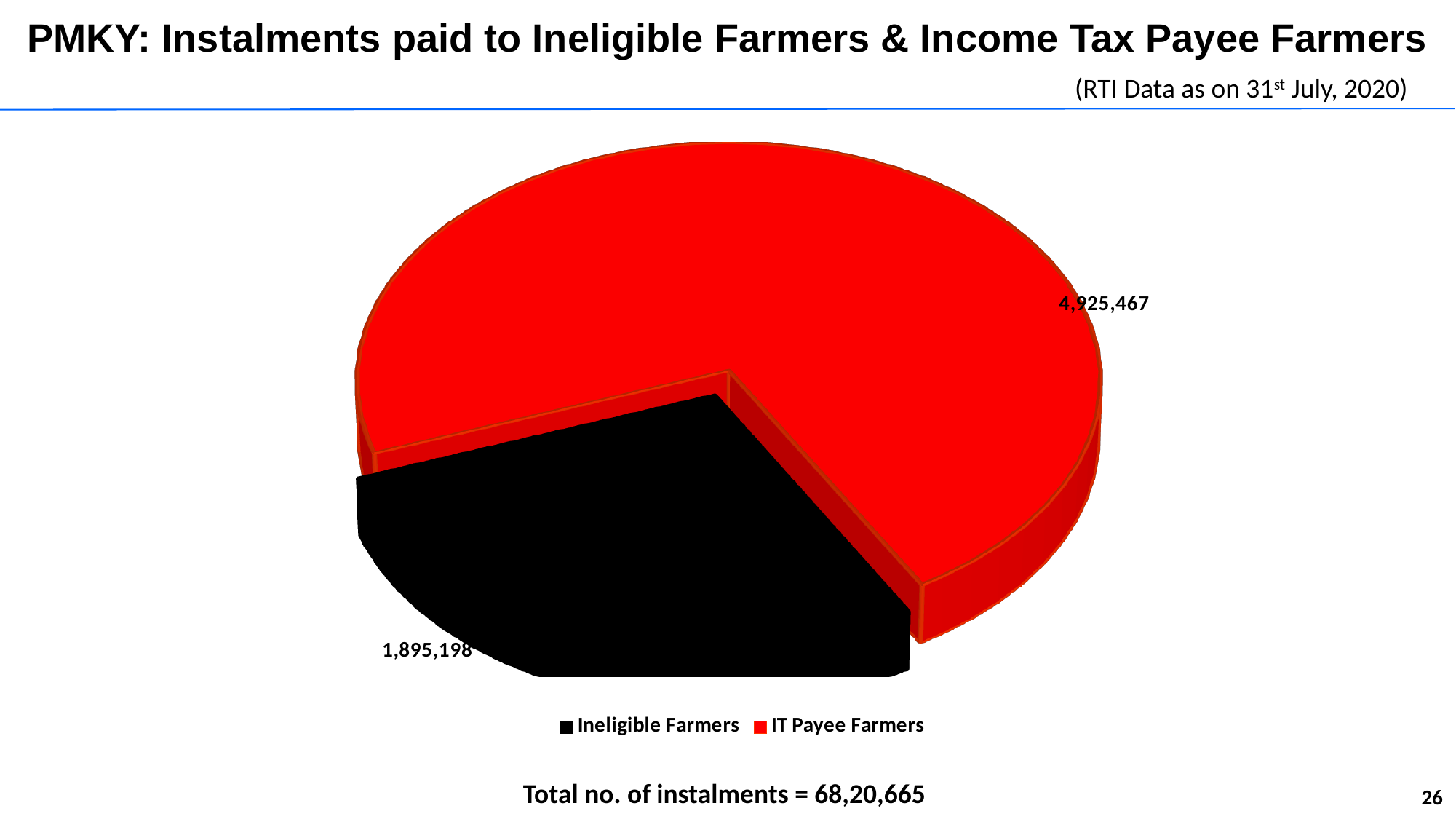
Which category has the larger slice of the pie? IT Payee Farmers What is the total number of instalments stated below the chart? 68,20,665 How many entries does the legend list? 2 How many instalments were paid to Ineligible Farmers according to the chart? 1,895,198 What colour represents Ineligible Farmers in the pie chart? Black What kind of chart is shown on the slide? Pie chart Which is larger: the value for Ineligible Farmers or the value for IT Payee Farmers? IT Payee Farmers As of what date is the RTI data shown on the slide? 31st July, 2020 What is the difference between the instalments paid to IT Payee Farmers and to Ineligible Farmers? 3,030,269 How many instalments were paid to IT Payee Farmers according to the chart? 4,925,467 How many slices does the pie chart have? 2 Which category has the smaller slice of the pie? Ineligible Farmers